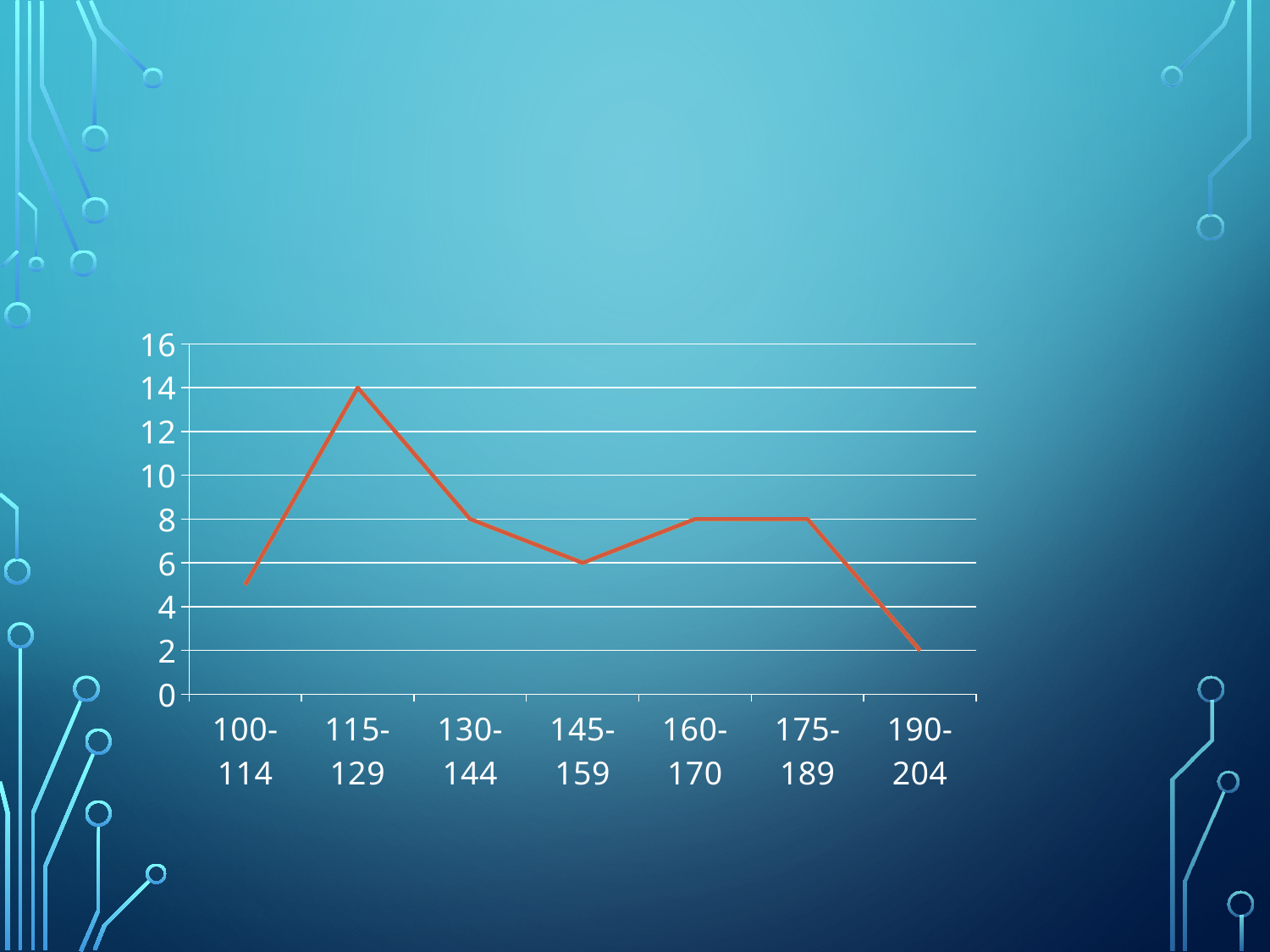
How many categories are shown on the x axis? 7 What is the difference between the values for 115-129 and 190-204? 12 What is the value for the 130-144 category? 8 Does the line rise or fall from 175-189 to 190-204? fall What kind of chart is shown on the slide? line chart Which category has the highest value? 115-129 Is the value for 100-114 greater or less than 6? less What is the value for the 145-159 category? 6 What is the value for the 190-204 category? 2 What is the value for the 115-129 category? 14 Which category has the lowest value? 190-204 Which has the larger value, 130-144 or 145-159? 130-144